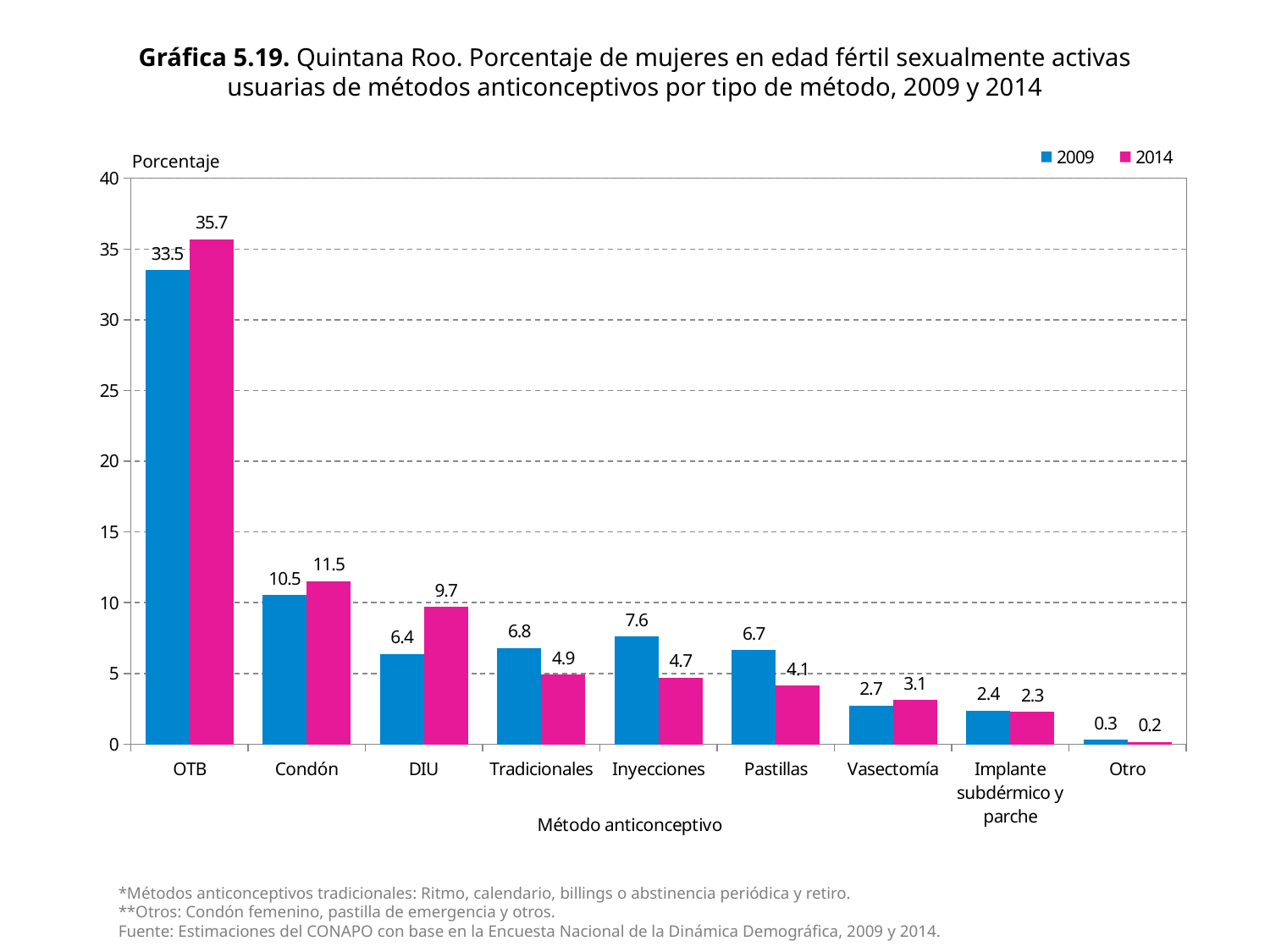
How many contraceptive method categories are shown on the x axis? 9 What is the value for Vasectomía in 2014? 3.1 What is the value for OTB in 2014? 35.7 How many series does the legend list? 2 What kind of chart is shown on the slide? Bar chart Which is larger for Tradicionales: the 2009 value or the 2014 value? 2009 Which method has the highest value in 2009? OTB Which is larger for Condón: the 2009 value or the 2014 value? 2014 What is the difference between the 2014 and 2009 values for DIU? 3.3 Which method has the lowest value in 2014? Otro What is the difference between the 2009 and 2014 values for Pastillas? 2.6 What is the value for Inyecciones in 2009? 7.6